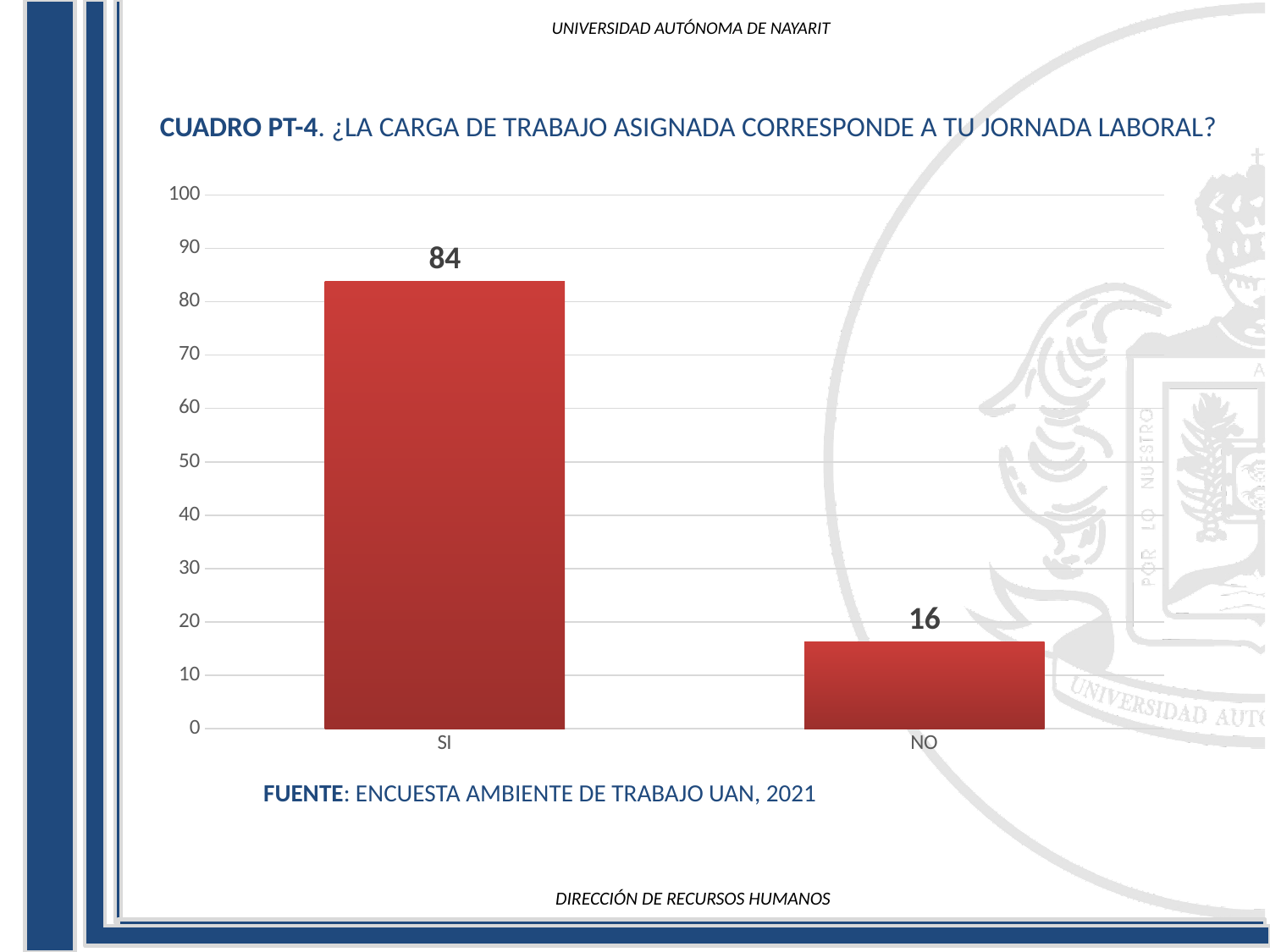
What is the value for SI? 84 What is the total of the two bars? 100 What is the value for NO? 16 Which is larger, the value for SI or the value for NO? SI What kind of chart is shown on the slide? bar chart Which category has the highest value? SI How many categories are shown on the x axis? 2 Is the value for SI greater or less than 80? greater What source is cited below the chart? ENCUESTA AMBIENTE DE TRABAJO UAN, 2021 Is the value for NO greater or less than 20? less What is the difference between the values for SI and NO? 68 Which category has the lowest value? NO